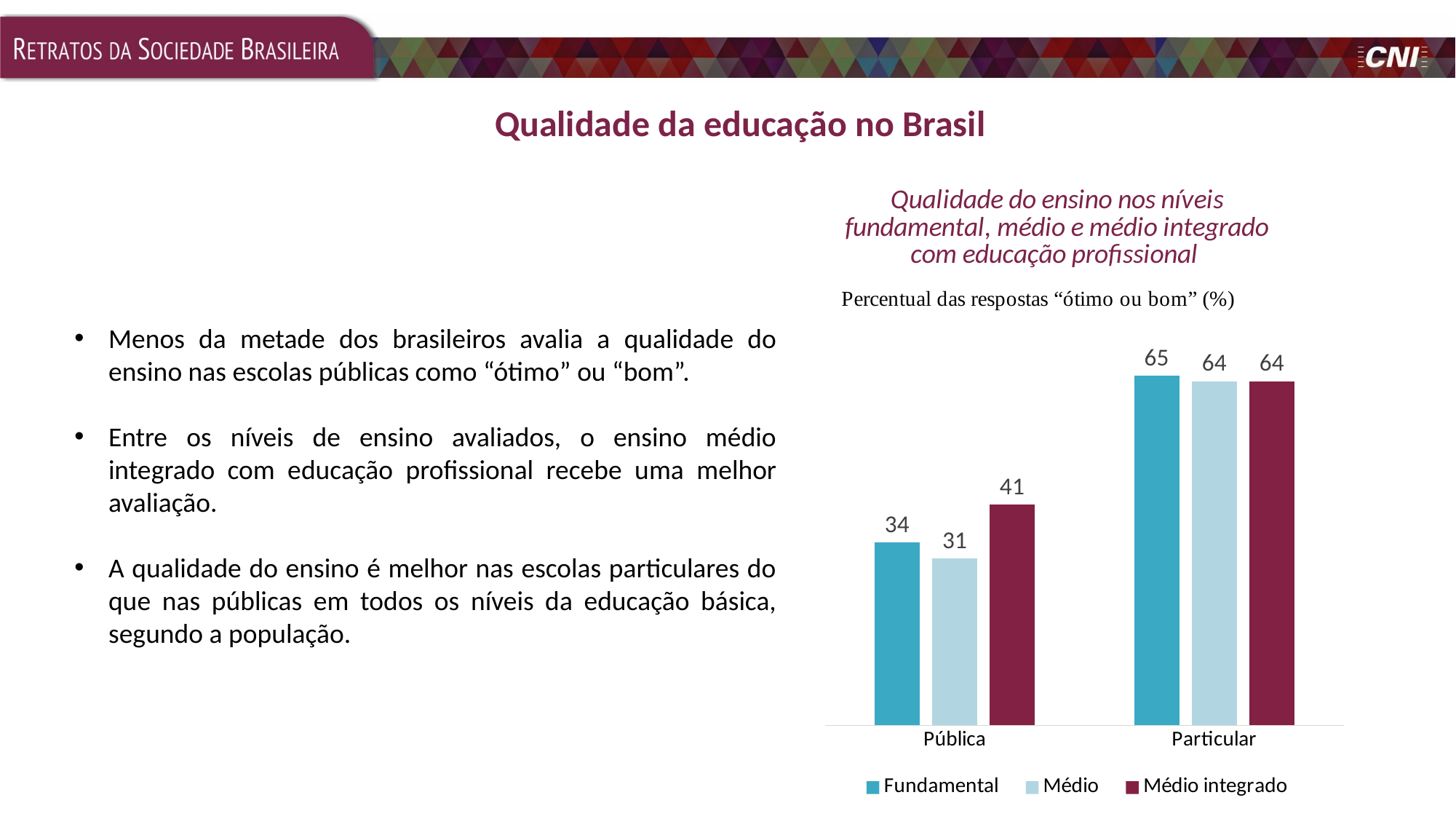
What kind of chart is shown on the slide? Bar chart What unit does the chart subtitle say the values are in? Percentual das respostas "ótimo ou bom" (%) How many categories are shown on the x axis? 2 Which is larger: the Fundamental value for Pública or the Fundamental value for Particular? Particular What is the difference between the Médio integrado values for Particular and Pública? 23 Which series has the highest value in the Pública category? Médio integrado What is the value for Médio in the Pública category? 31 What is the value for Médio integrado in the Particular category? 64 How many series does the legend list? 3 What is the value for Fundamental in the Particular category? 65 Which series has the lowest value in the Pública category? Médio What is the value for Fundamental in the Pública category? 34